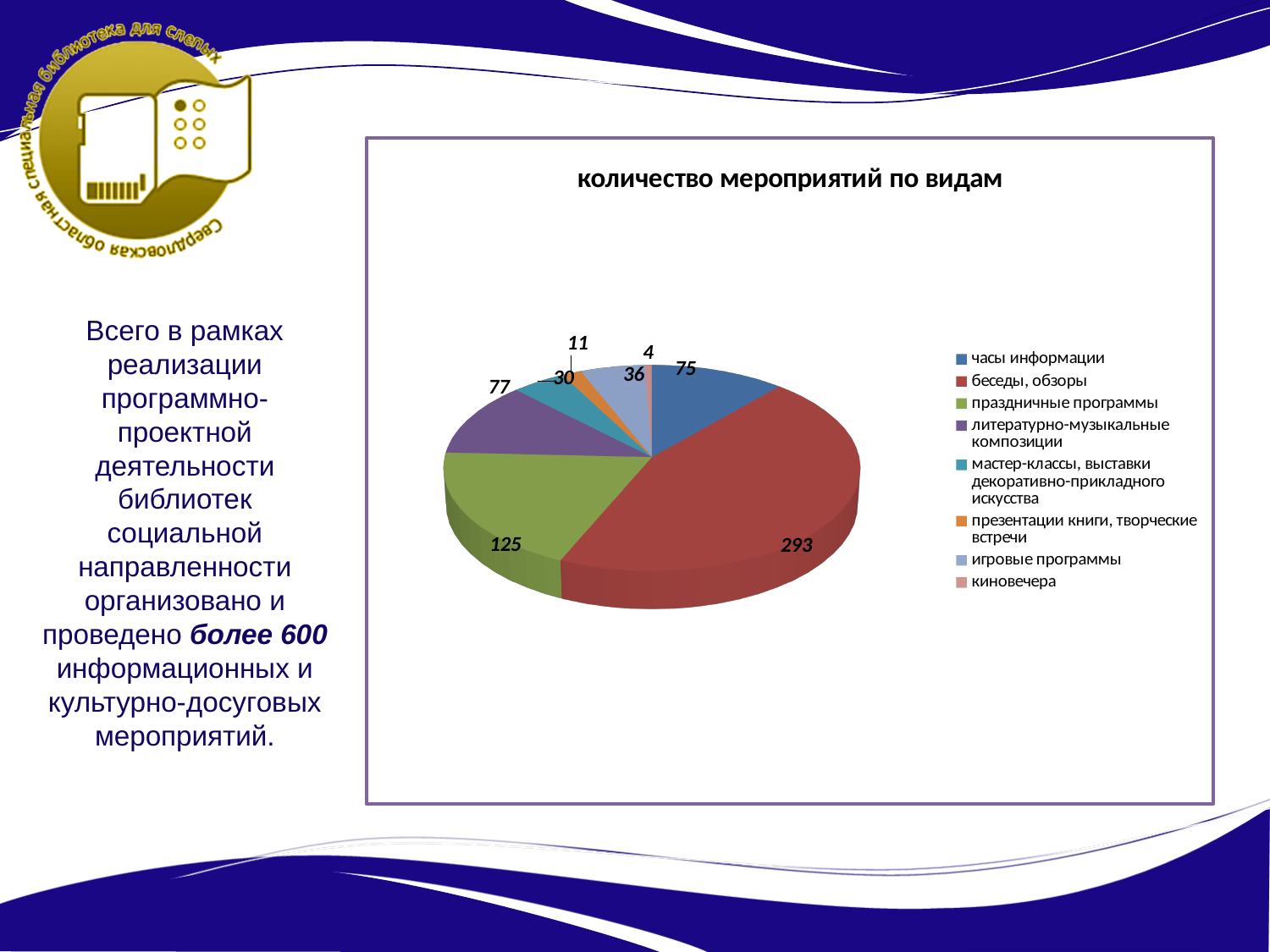
What is the value for киновечера? 4 What is the title of the chart? количество мероприятий по видам How many categories does the legend of the pie chart list? 8 What is the value for беседы, обзоры? 293 What is the value for игровые программы? 36 Which category has the largest slice of the pie? беседы, обзоры What is the value for праздничные программы? 125 What type of chart is shown on the slide? pie chart What is the total of all the values shown on the pie chart? 651 Which category has the smallest slice of the pie? киновечера Which is larger: the value for часы информации or the value for литературно-музыкальные композиции? литературно-музыкальные композиции What is the difference between the values for беседы, обзоры and праздничные программы? 168